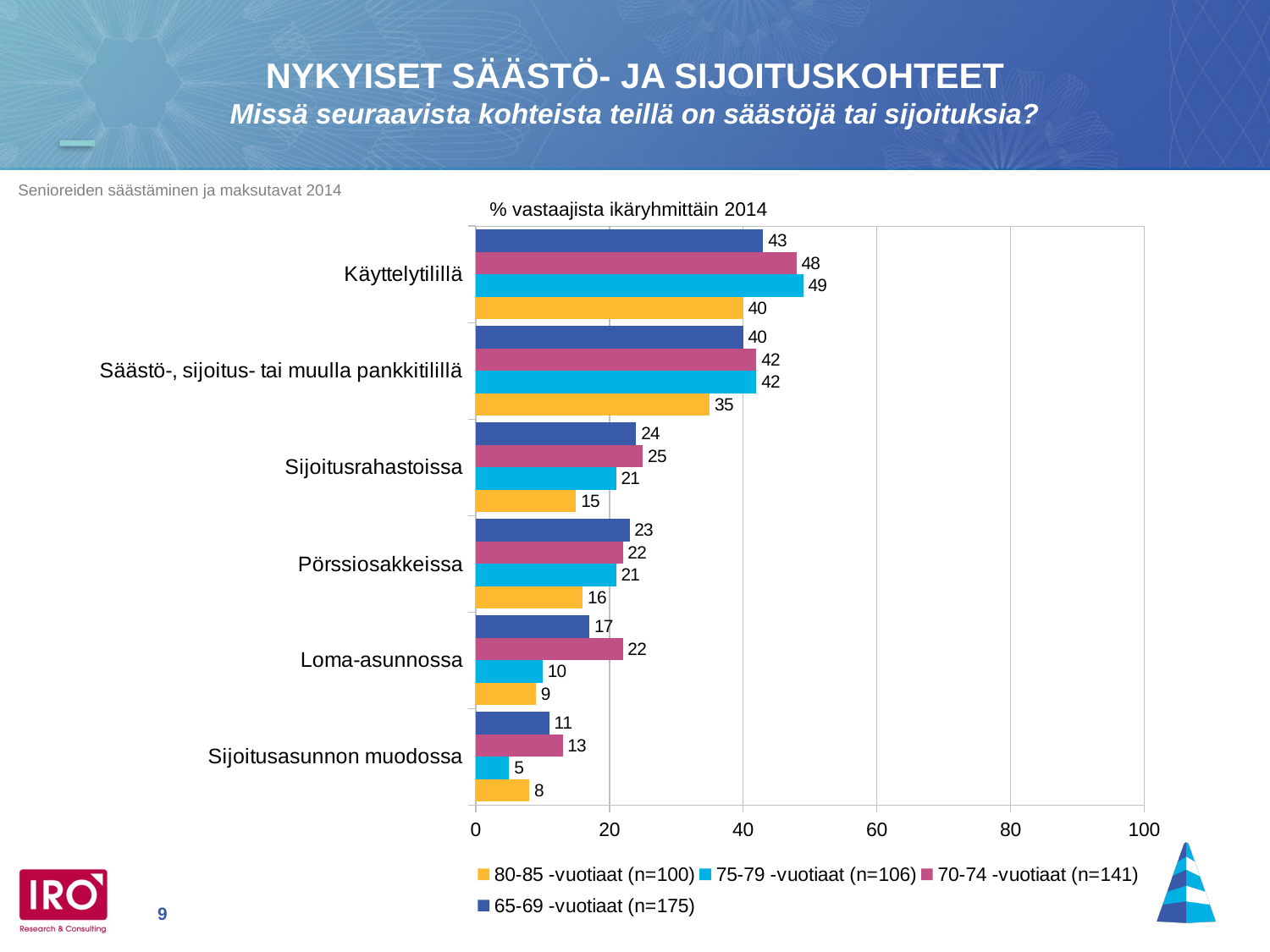
What is the value for 75-79 -vuotiaat in the Käyttelytilillä category? 49 Is the value for 70-74 -vuotiaat in the Käyttelytilillä category greater or less than 40? greater What is the difference between the 70-74 -vuotiaat and 80-85 -vuotiaat values in the Sijoitusrahastoissa category? 10 How many categories are shown on the chart? 6 What is the value for 80-85 -vuotiaat in the Säästö-, sijoitus- tai muulla pankkitilillä category? 35 Which category has the highest value for 65-69 -vuotiaat? Käyttelytilillä What is the value for 70-74 -vuotiaat in the Loma-asunnossa category? 22 Which category has the lowest value for 75-79 -vuotiaat? Sijoitusasunnon muodossa In the Loma-asunnossa category, which is larger: the value for 65-69 -vuotiaat or for 75-79 -vuotiaat? 65-69 -vuotiaat What type of chart is shown on the slide? bar chart How many series does the legend list? 4 What is the title shown above the chart's plot area? % vastaajista ikäryhmittäin 2014